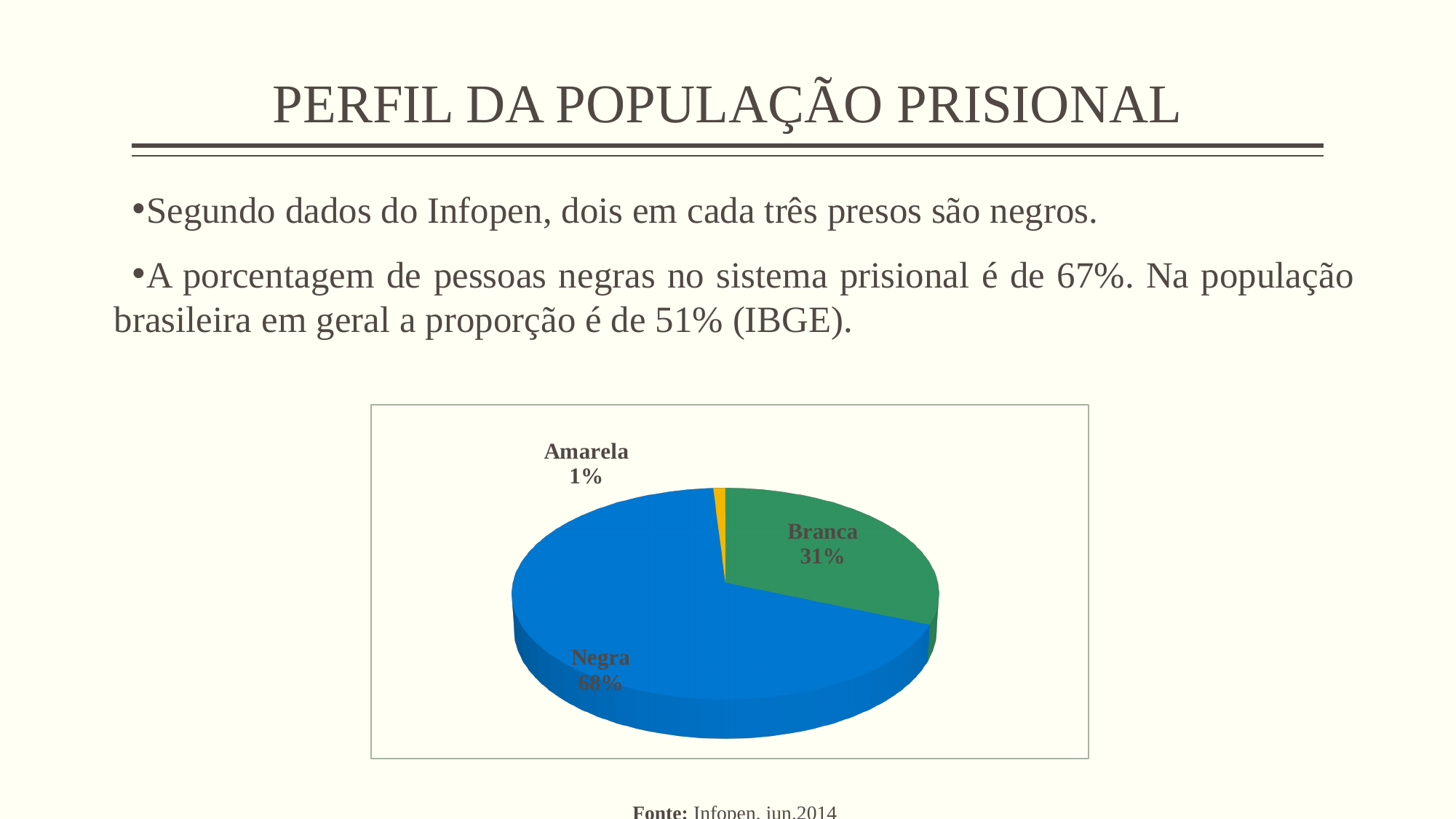
What is the difference in percentage points between the Branca and Amarela slices? 30 Which category has the smallest slice of the pie? Amarela What colour is the Negra slice of the pie? blue What share of the pie does the Amarela slice represent? 1% What colour is the Branca slice of the pie? green What kind of chart is shown on the slide? pie chart What share of the pie does the Negra slice represent? 68% What is the difference in percentage points between the Negra and Branca slices? 37 Which category has the largest slice of the pie? Negra How many categories are shown in the pie chart? 3 Which slice is larger, Branca or Amarela? Branca What share of the pie does the Branca slice represent? 31%